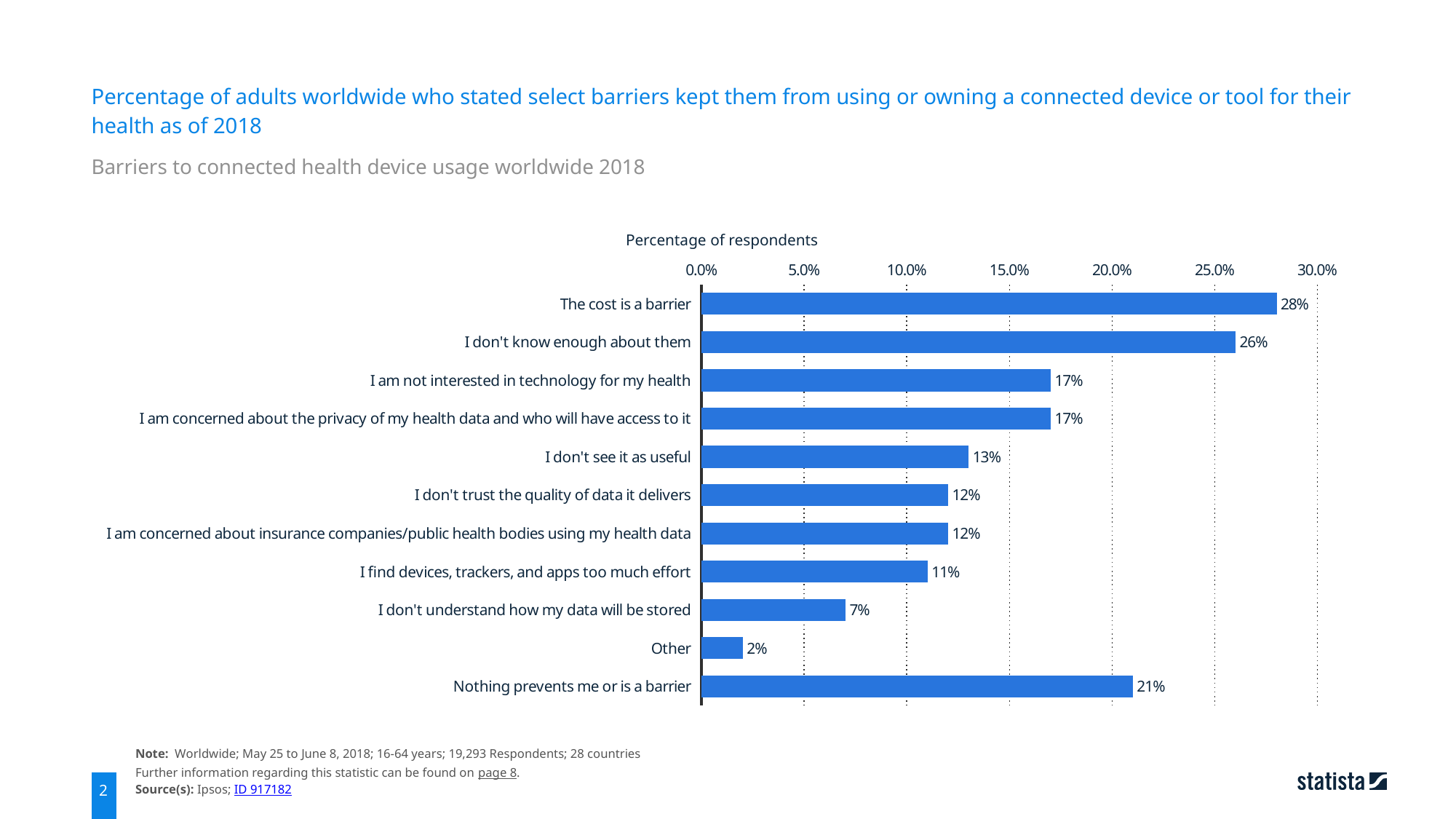
Which has a higher percentage: 'I don't know enough about them' or 'Nothing prevents me or is a barrier'? I don't know enough about them Is the value for 'I am not interested in technology for my health' greater or less than 15.0%? greater What kind of chart is shown on the slide? Bar chart What percentage of respondents said 'I don't understand how my data will be stored'? 7% How many categories are shown in the chart? 11 Which category has the lowest percentage of respondents? Other What is the difference in percentage points between 'The cost is a barrier' and 'I don't know enough about them'? 2 What is the difference in percentage points between 'I don't see it as useful' and 'I find devices, trackers, and apps too much effort'? 2 Which barrier has the highest percentage of respondents? The cost is a barrier What percentage of respondents said 'Nothing prevents me or is a barrier'? 21% What is the label of the horizontal axis of the chart? Percentage of respondents What percentage of respondents stated that the cost is a barrier? 28%